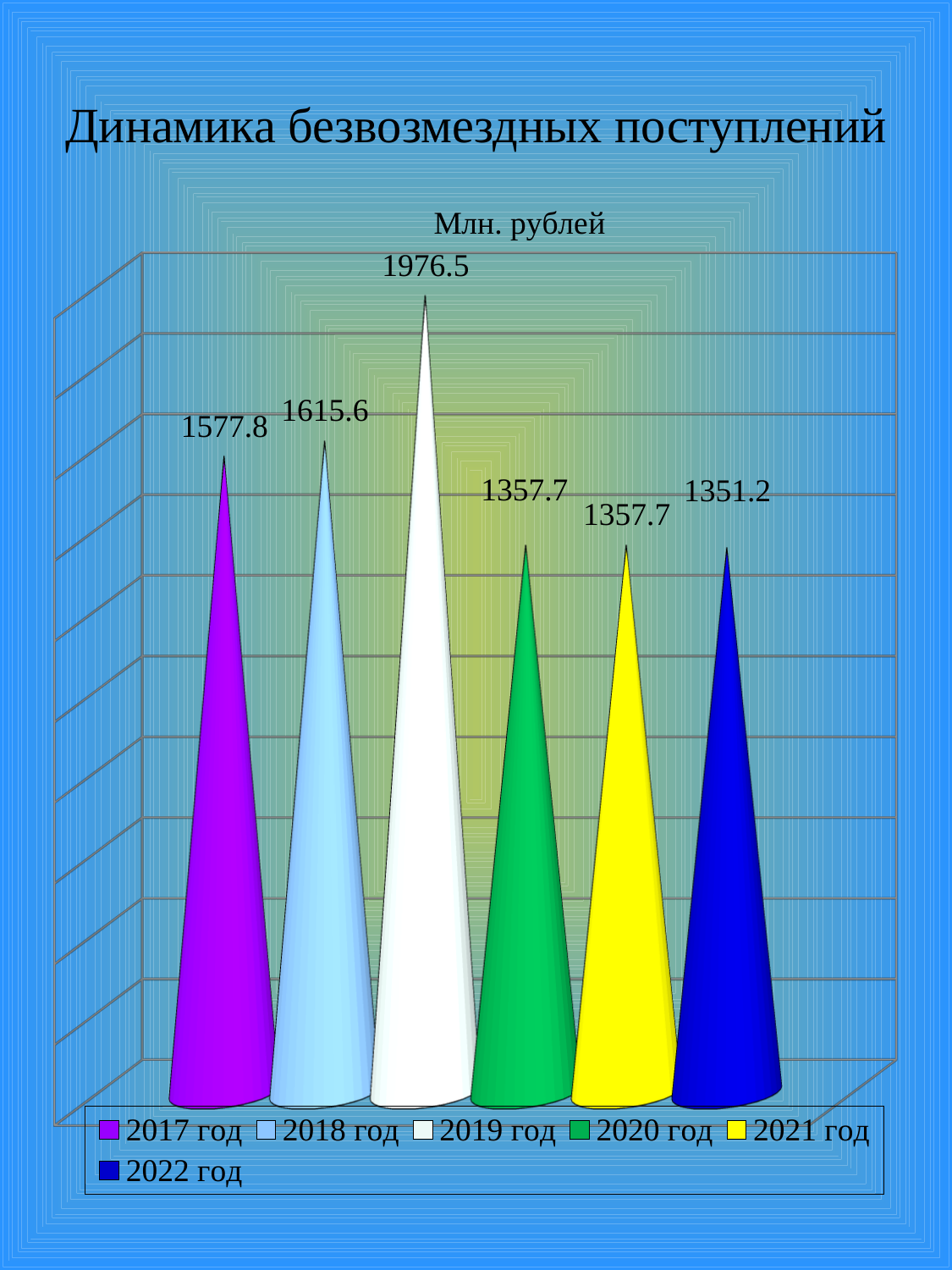
What unit is shown above the chart? Млн. рублей How many entries does the legend list? 6 What is the difference between the values for 2019 год and 2018 год? 360.9 Which year has the highest value? 2019 год What is the value for 2019 год? 1976.5 How many years are plotted on the chart? 6 Which year has the lowest value? 2022 год What is the difference between the values for 2018 год and 2017 год? 37.8 What is the value for 2022 год? 1351.2 What is the value for 2017 год? 1577.8 Which is larger, the value for 2017 год or the value for 2020 год? 2017 год What kind of chart is shown on the slide? 3D bar chart